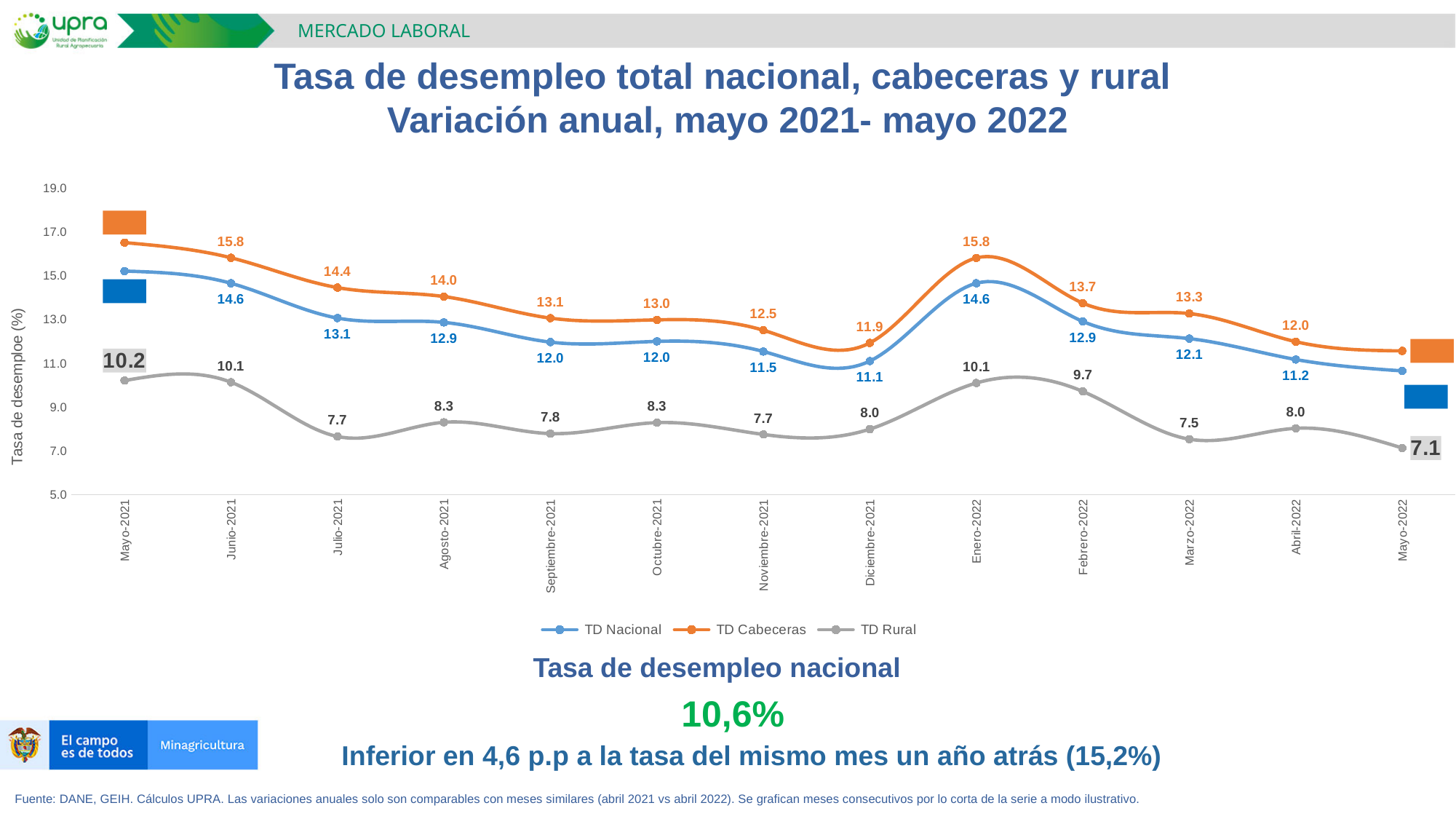
Which is larger for TD Nacional: Julio-2021 or Febrero-2022? Julio-2021 What is the TD Rural value for Mayo-2022? 7.1 Is the TD Cabeceras value for Mayo-2021 greater or less than 15.0? greater What kind of chart is shown on the slide? line chart In which month is the TD Rural series at its lowest? Mayo-2022 How many months are plotted on the x axis? 13 What is the TD Cabeceras value for Enero-2022? 15.8 What is the TD Nacional value for Diciembre-2021? 11.1 How many series does the legend list? 3 What is the difference between the TD Cabeceras values for Junio-2021 and Abril-2022? 3.8 In which month is the TD Rural series at its highest? Mayo-2021 Does the TD Nacional series rise or fall from Enero-2022 to Mayo-2022? fall